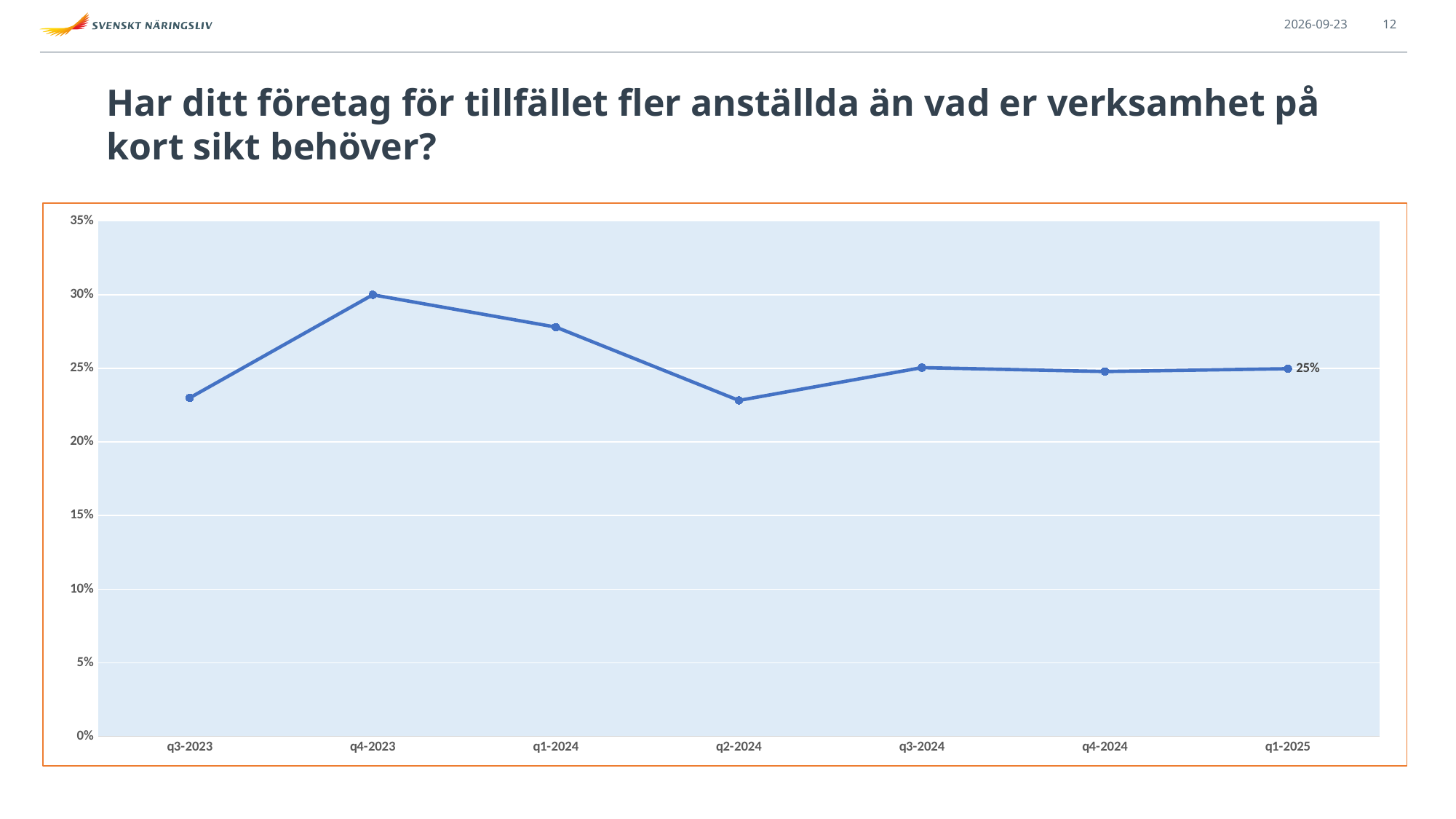
What is the highest value shown on the vertical axis? 35% What kind of chart is shown on the slide? line chart Does the value rise or fall from q4-2023 to q2-2024? fall What is the value for q1-2025? 25% Which is larger, the value for q1-2024 or the value for q2-2024? q1-2024 Does the value rise or fall from q3-2023 to q4-2023? rise Is the value for q3-2023 greater or less than 25%? less Is the value for q2-2024 greater or less than 25%? less Which quarter has the highest value? q4-2023 Is the value for q1-2024 greater or less than 25%? greater What is the value for q4-2023? 30% How many quarters are plotted on the chart? 7